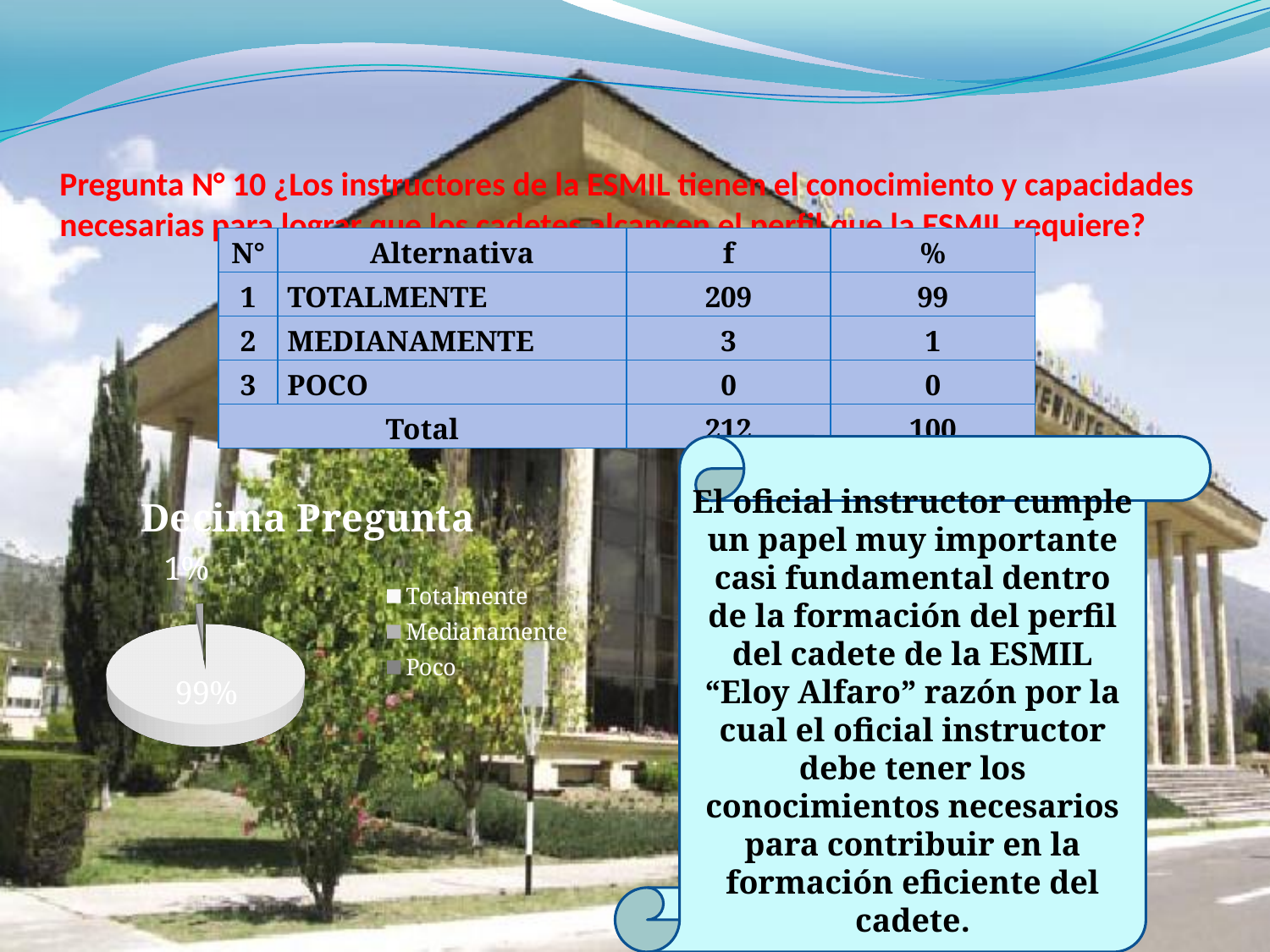
What is the difference between the Totalmente share and the Medianamente share? 98% Is the share for Totalmente greater or less than 50%? greater How many entries does the pie chart's legend list? 3 What share of the pie does Medianamente represent? 1% What is the title of the pie chart? Decima Pregunta Which category has the largest slice of the pie? Totalmente Of the two labeled slices, Totalmente and Medianamente, which is smaller? Medianamente What share of the pie does Totalmente represent? 99% Which is larger in the pie chart, Totalmente or Medianamente? Totalmente What are the three legend entries of the pie chart? Totalmente, Medianamente, Poco What kind of chart is shown on the slide? pie chart